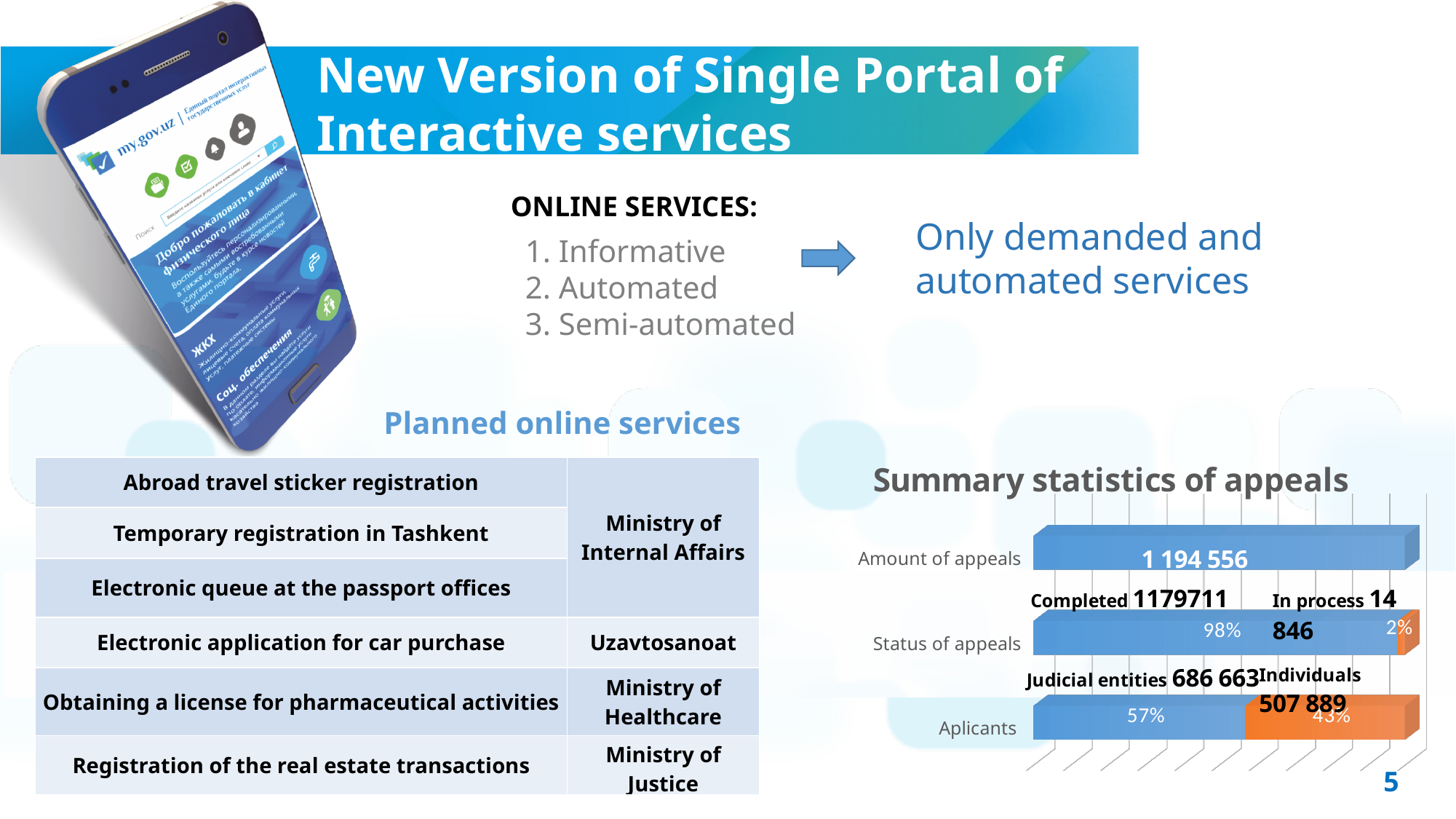
In the Summary statistics of appeals chart, what percentage of Aplicants are Judicial entities? 57% In the Summary statistics of appeals chart, which is larger among Aplicants: Judicial entities or Individuals? Judicial entities In the Summary statistics of appeals chart, how many appeals are labelled as In process? 14 846 In the Summary statistics of appeals chart, what is the difference between the Judicial entities value and the Individuals value? 178 774 How many categories (rows) are shown on the vertical axis of the Summary statistics of appeals chart? 3 In the Summary statistics of appeals chart, what is the value for Individuals among Aplicants? 507 889 In the Summary statistics of appeals chart, how many appeals are labelled as Completed? 1179711 In the Summary statistics of appeals chart, what percentage of appeals is shown as Completed? 98% In the Summary statistics of appeals chart, what is the value shown for Amount of appeals? 1 194 556 In the Summary statistics of appeals chart, what is the value for Judicial entities among Aplicants? 686 663 What is the title of the chart on the right side of the slide? Summary statistics of appeals What kind of chart is the Summary statistics of appeals chart? Bar chart